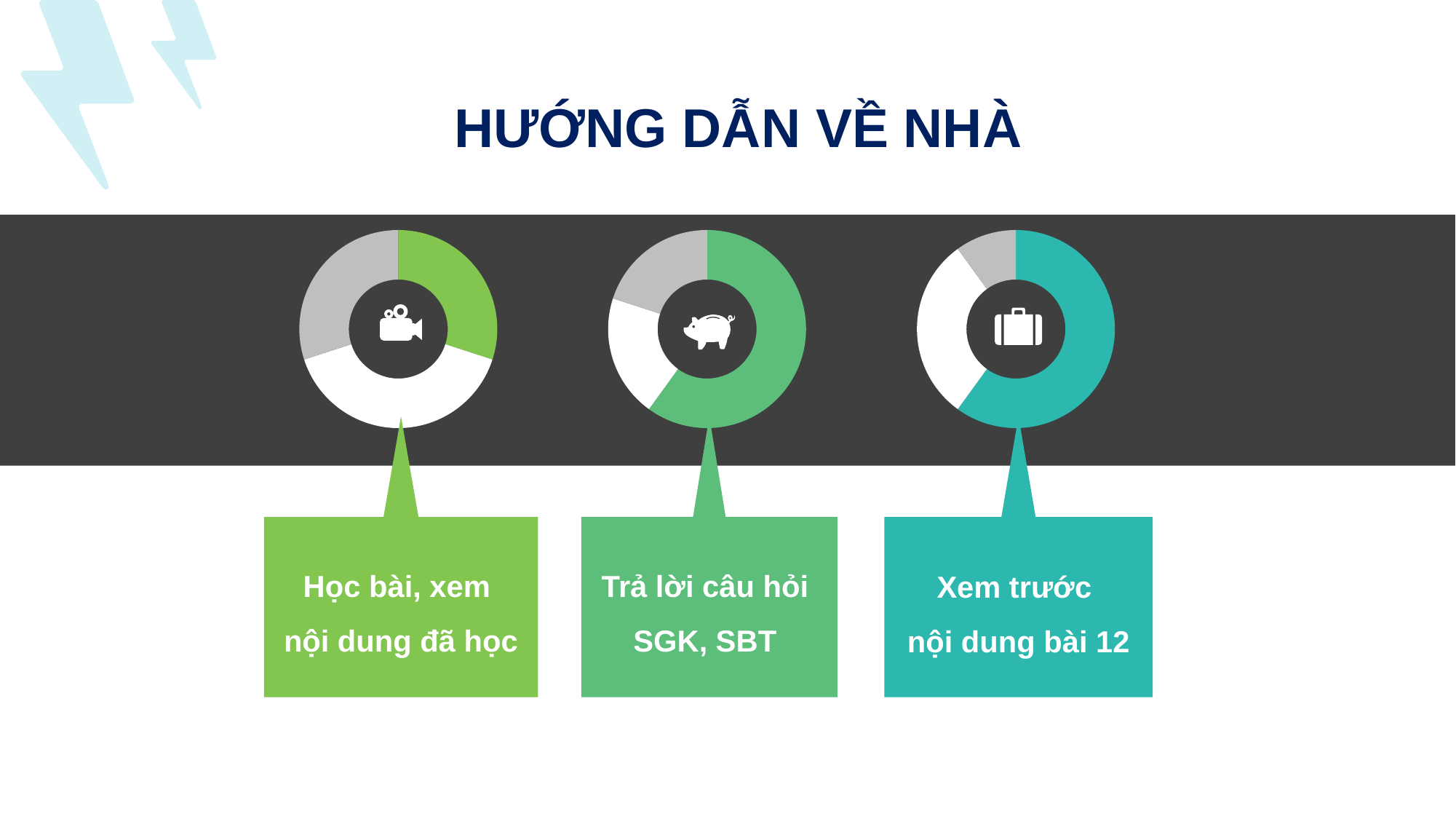
What kind of chart is used for the three graphics in the dark band? Donut (pie) chart What is the title of the slide containing the three donut charts? HƯỚNG DẪN VỀ NHÀ What colour is the coloured slice of the right donut chart? Teal In the right donut chart, is the teal slice larger or smaller than the grey slice? Larger How many donut charts are shown on the slide? 3 In the right donut chart (above "Xem trước nội dung bài 12"), which slice is the smallest: the teal, the white or the grey? Grey In the middle donut chart (above "Trả lời câu hỏi SGK, SBT"), which slice is the largest: the green, the white or the grey? Green How many slices does the left donut chart (above "Học bài, xem nội dung đã học") have? 3 In the middle donut chart, is the grey slice larger or smaller than the green slice? Smaller